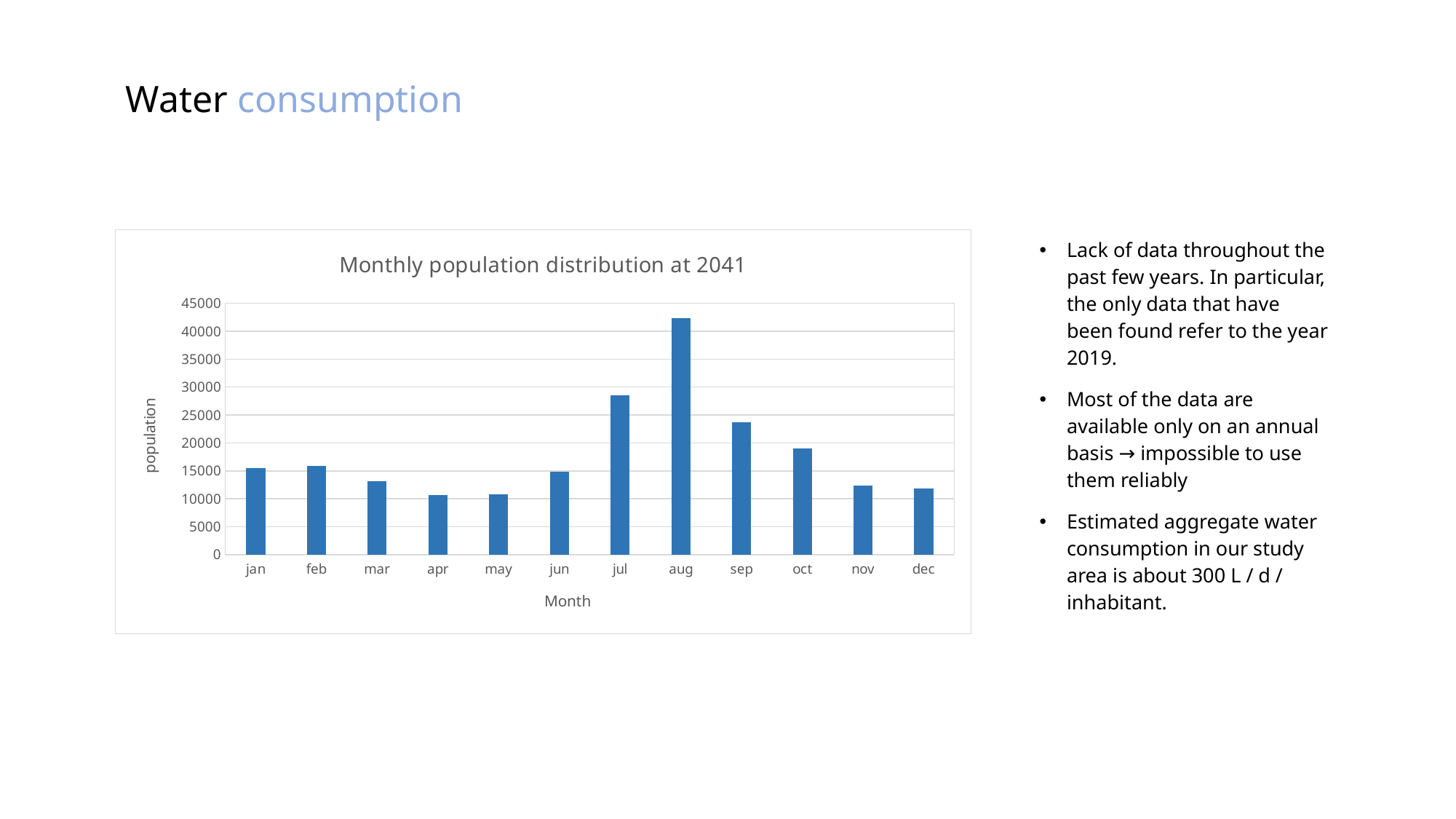
Is the value for jul greater or less than 25000? greater Which month has the larger population, jul or sep? jul Is the value for apr greater or less than 15000? less Which month has the highest population in the chart? aug What is the label of the vertical axis of the chart? population Is the value for oct greater or less than 20000? less Do the values rise or fall from aug to dec? fall What type of chart is shown on the slide? bar chart How many months are plotted on the x axis of the chart? 12 What is the title of the chart? Monthly population distribution at 2041